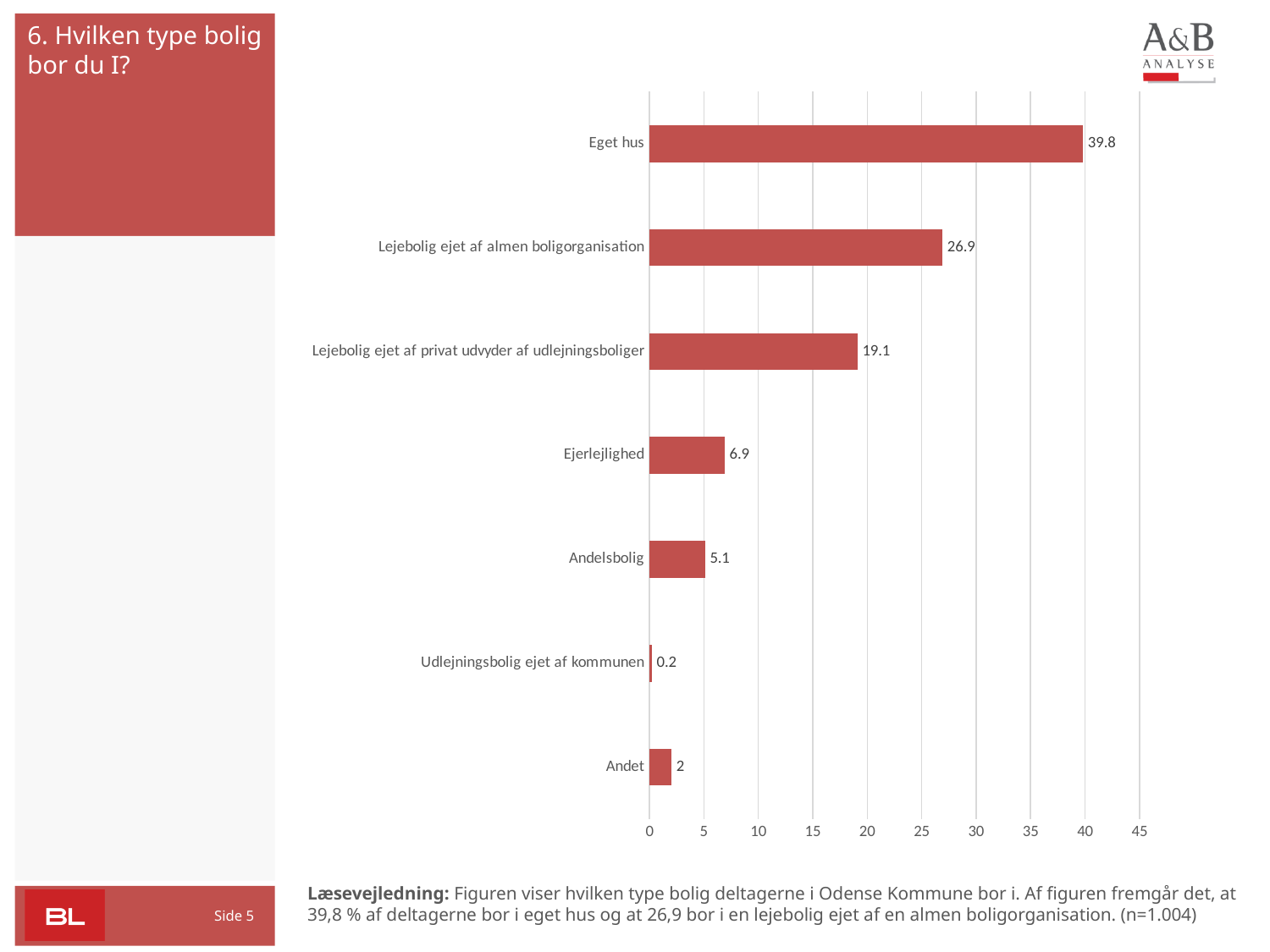
How many categories are shown in the chart? 7 What is the difference between the values for Eget hus and Lejebolig ejet af almen boligorganisation? 12.9 What is the value for Eget hus? 39.8 What kind of chart is shown on the slide? bar chart What is the value for Andelsbolig? 5.1 Is the value for Lejebolig ejet af privat udvyder af udlejningsboliger greater or less than 20? less What is the highest tick value shown on the horizontal axis? 45 What is the value for Udlejningsbolig ejet af kommunen? 0.2 Which category has the lowest value? Udlejningsbolig ejet af kommunen Which category has the highest value? Eget hus Which is larger, the value for Ejerlejlighed or the value for Andelsbolig? Ejerlejlighed What is the value for Lejebolig ejet af almen boligorganisation? 26.9